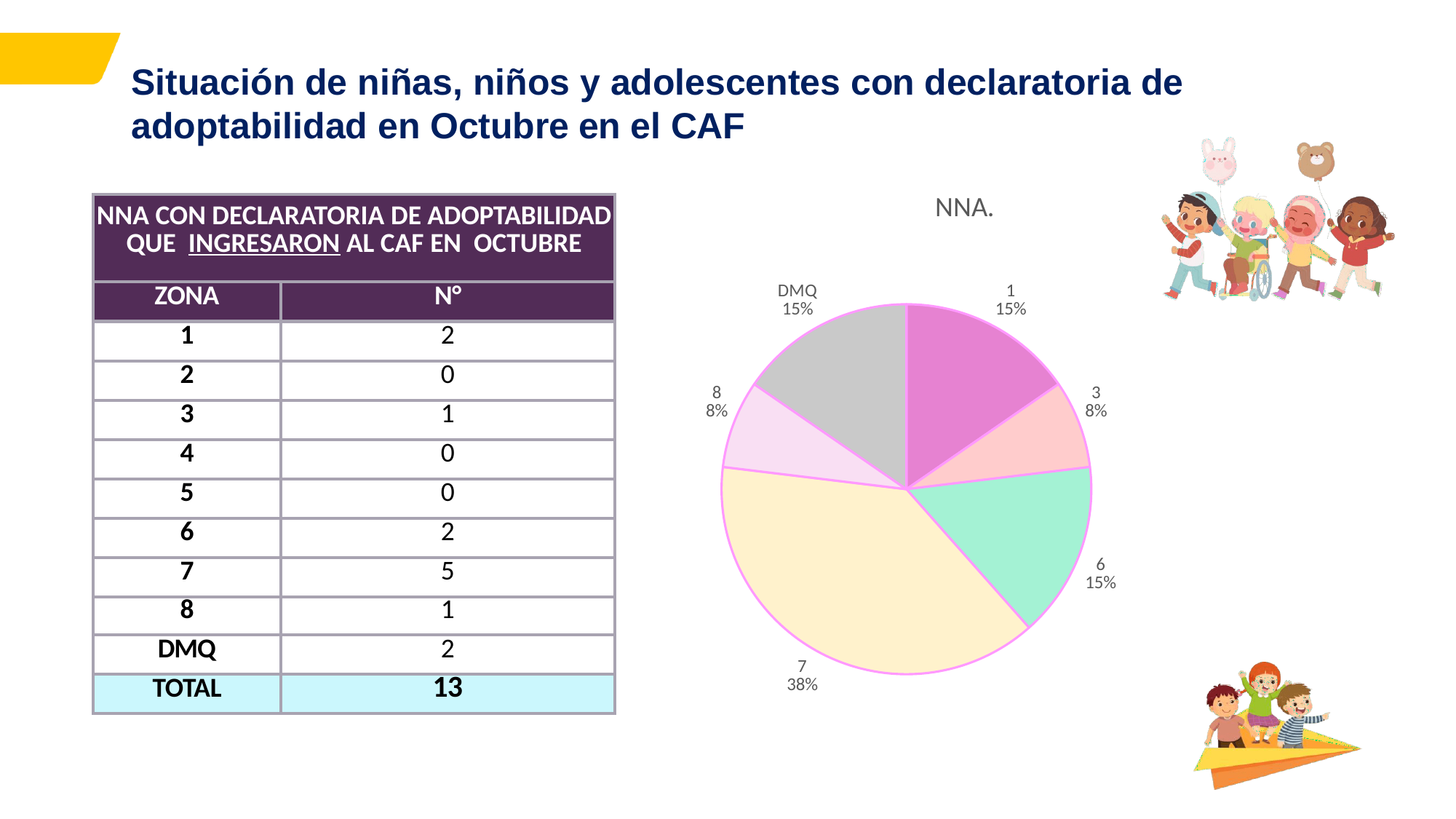
What share of the pie does zone 3 represent? 8% What share of the pie does DMQ represent? 15% What share of the pie does zone 8 represent? 8% What is the title of the pie chart? NNA. Which slice is larger in the pie chart, zone 6 or zone 3? zone 6 How many slices does the pie chart have? 6 What is the difference in percentage points between the share for zone 6 and the share for zone 8? 7 What colour is the slice for zone 7 in the pie chart? light yellow Which slice of the pie chart is the largest? 7 What kind of chart is shown on the slide? pie chart What is the difference in percentage points between the share for zone 7 and the share for zone 1? 23